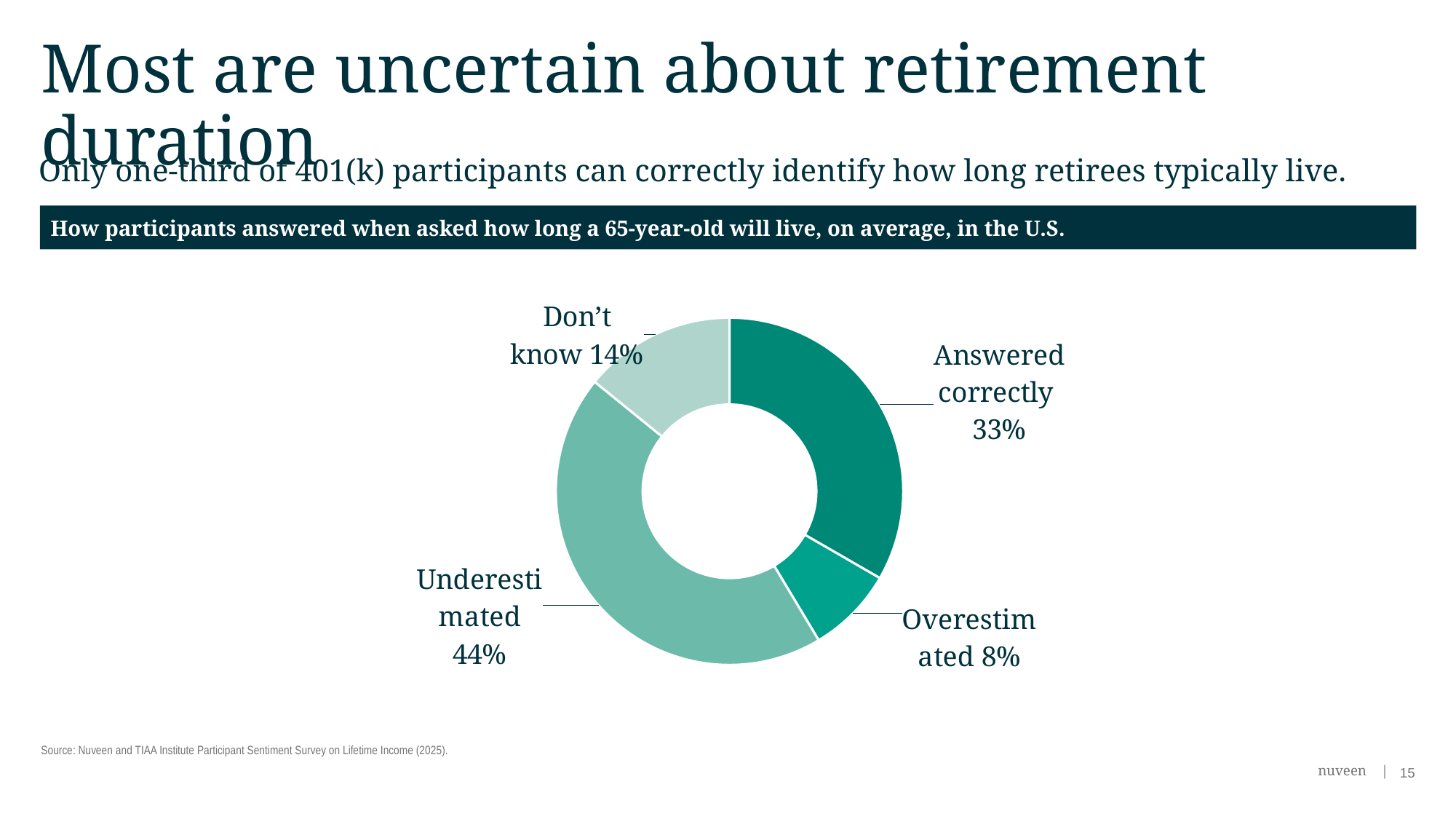
What is the title of the chart? How participants answered when asked how long a 65-year-old will live, on average, in the U.S. What percentage of participants underestimated how long a 65-year-old will live? 44% What percentage of participants said they don't know? 14% What percentage of participants overestimated? 8% Which is larger, the share that answered correctly or the share that don't know? Answered correctly What kind of chart is shown on the slide? Doughnut (pie) chart Which response category has the smallest share? Overestimated What is the difference in percentage points between Underestimated and Answered correctly? 11 What is the combined share of participants who underestimated or overestimated? 52% How many response categories are shown in the chart? 4 Which response category has the largest share? Underestimated What percentage of participants answered correctly? 33%